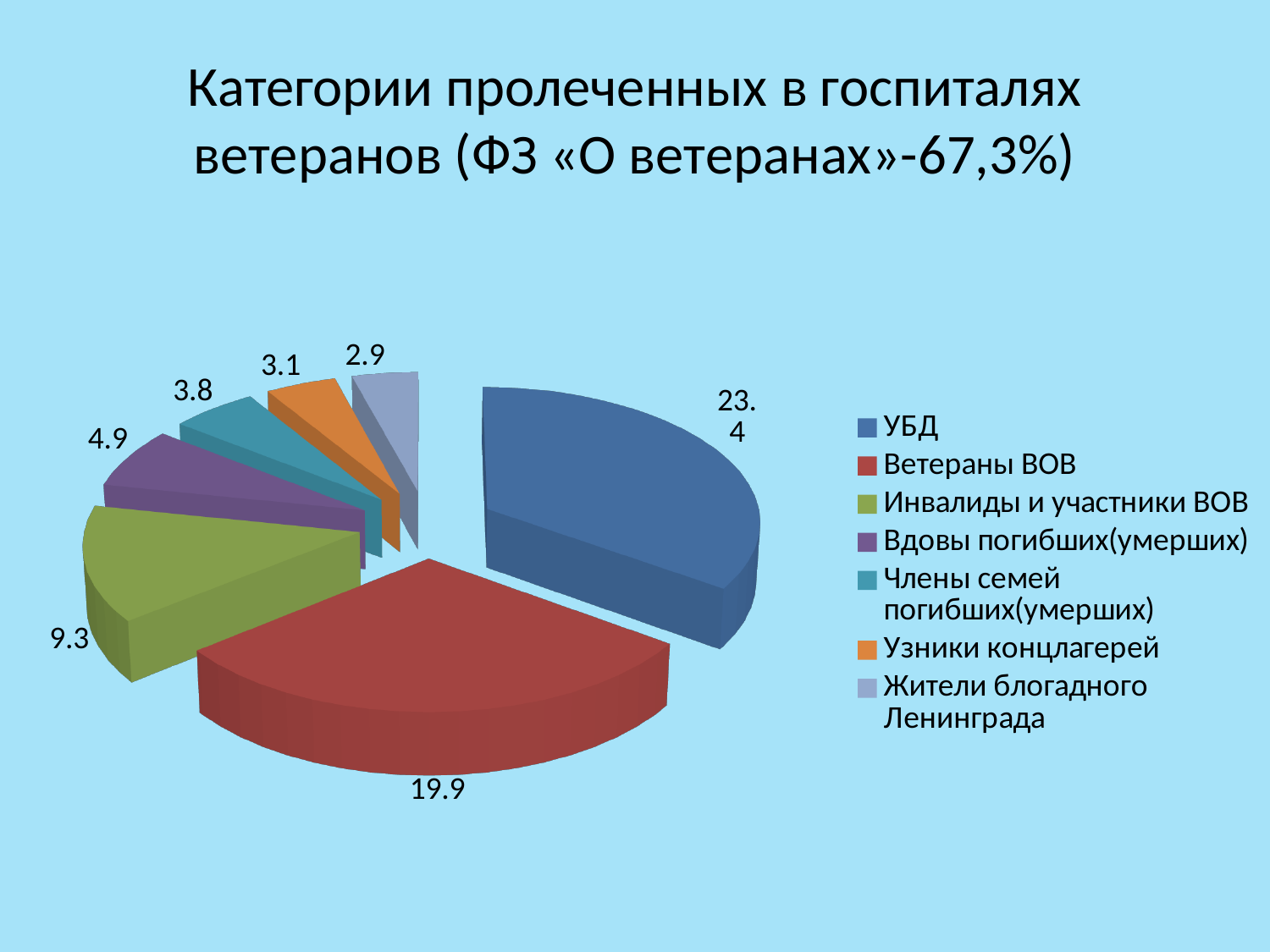
What is the value for Инвалиды и участники ВОВ? 9.3 What is the difference between the values for Вдовы погибших(умерших) and Члены семей погибших(умерших)? 1.1 Which category has the largest slice of the pie? УБД How many categories does the pie chart show? 7 What is the difference between the values for УБД and Ветераны ВОВ? 3.5 What is the value for УБД? 23.4 Which category has the smallest slice of the pie? Жители блогадного Ленинграда What is the value for Ветераны ВОВ? 19.9 What type of chart is shown on the slide? pie chart What is the value for Узники концлагерей? 3.1 What colour is the slice for Ветераны ВОВ? red Which is larger: the value for Инвалиды и участники ВОВ or the value for Вдовы погибших(умерших)? Инвалиды и участники ВОВ